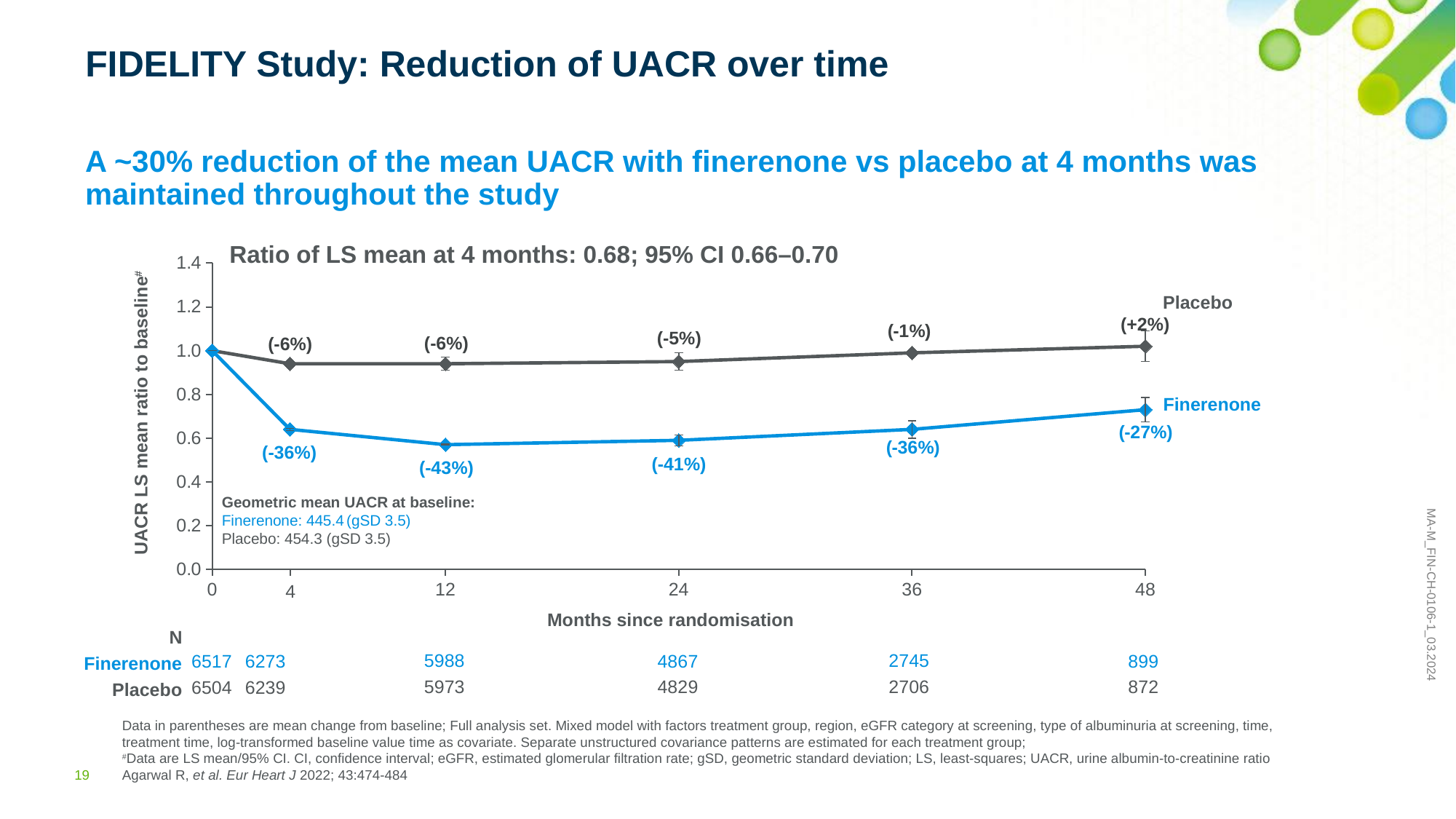
Is the UACR LS mean ratio for finerenone at 48 months greater or less than 0.8? less What kind of chart is shown on the slide? Line chart What is the labelled mean change from baseline for finerenone at 12 months? -43% What is the labelled mean change from baseline for placebo at 48 months? +2% Is the UACR LS mean ratio for placebo at 36 months greater or less than 0.8? greater How many time points are plotted on the x axis for each series? 6 What is the ratio of LS mean at 4 months stated in the chart title? 0.68 Does the finerenone series rise or fall between 12 and 48 months? Rise How many series are plotted in the chart? 2 What is the labelled mean change from baseline for finerenone at 4 months? -36% Which series has the lower UACR LS mean ratio at 24 months, finerenone or placebo? Finerenone At which month does the finerenone series show its largest labelled reduction from baseline? 12